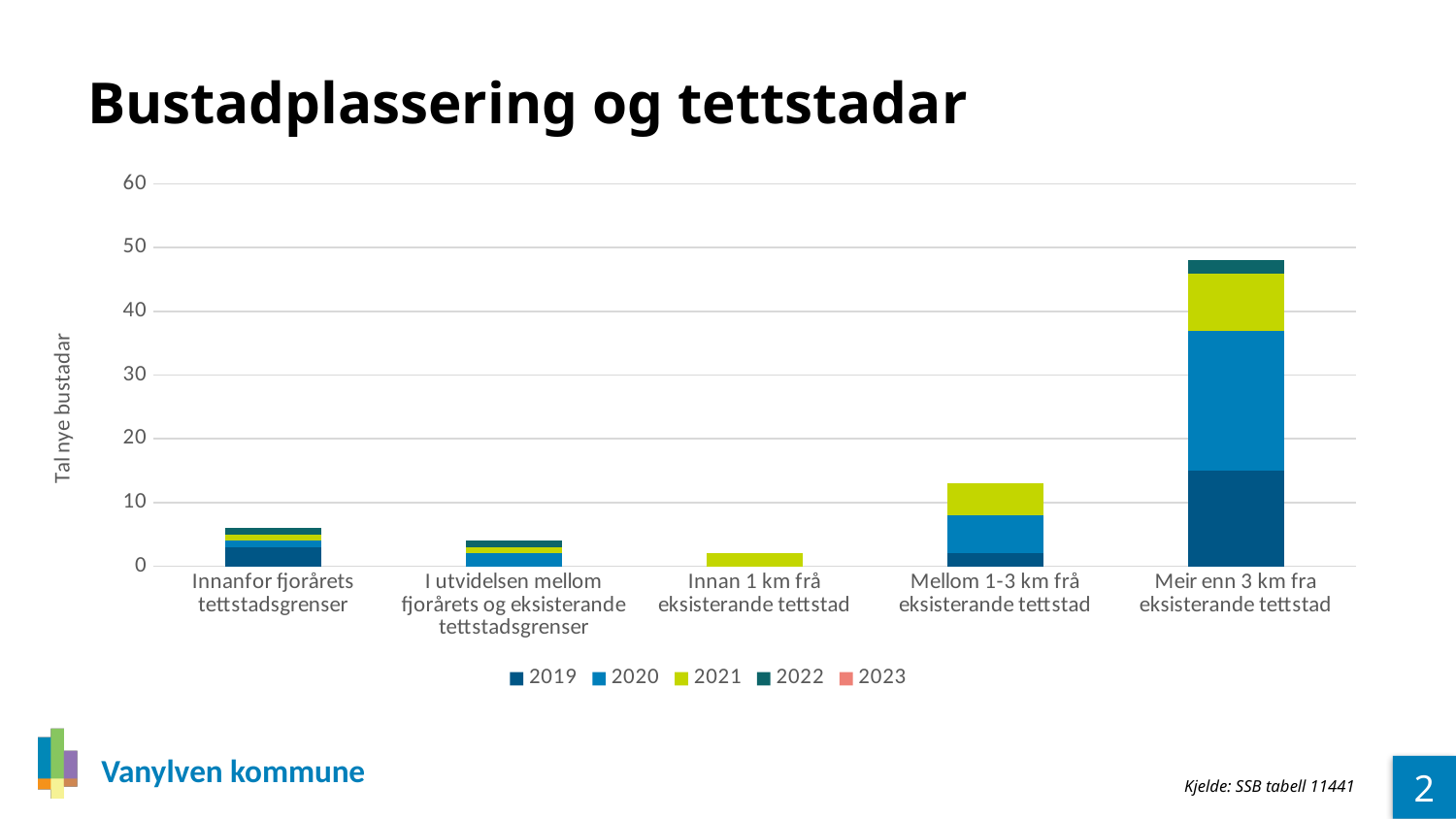
What is the title of the chart? Bustadplassering og tettstadar Is the total stacked value for 'Meir enn 3 km fra eksisterande tettstad' greater or less than 40? greater Which category has the tallest stacked bar? Meir enn 3 km fra eksisterande tettstad Which has the larger stacked total: 'Meir enn 3 km fra eksisterande tettstad' or 'Mellom 1-3 km frå eksisterande tettstad'? Meir enn 3 km fra eksisterande tettstad What is the label on the y axis? Tal nye bustadar Which category has the shortest stacked bar? Innan 1 km frå eksisterande tettstad Is the total stacked value for 'Mellom 1-3 km frå eksisterande tettstad' greater or less than 10? greater Which has the larger stacked total: 'Mellom 1-3 km frå eksisterande tettstad' or 'Innanfor fjorårets tettstadsgrenser'? Mellom 1-3 km frå eksisterande tettstad Is the total stacked value for 'Innanfor fjorårets tettstadsgrenser' greater or less than 10? less How many categories are shown on the x axis? 5 How many series does the legend list? 5 What kind of chart is shown on the slide? Stacked bar chart